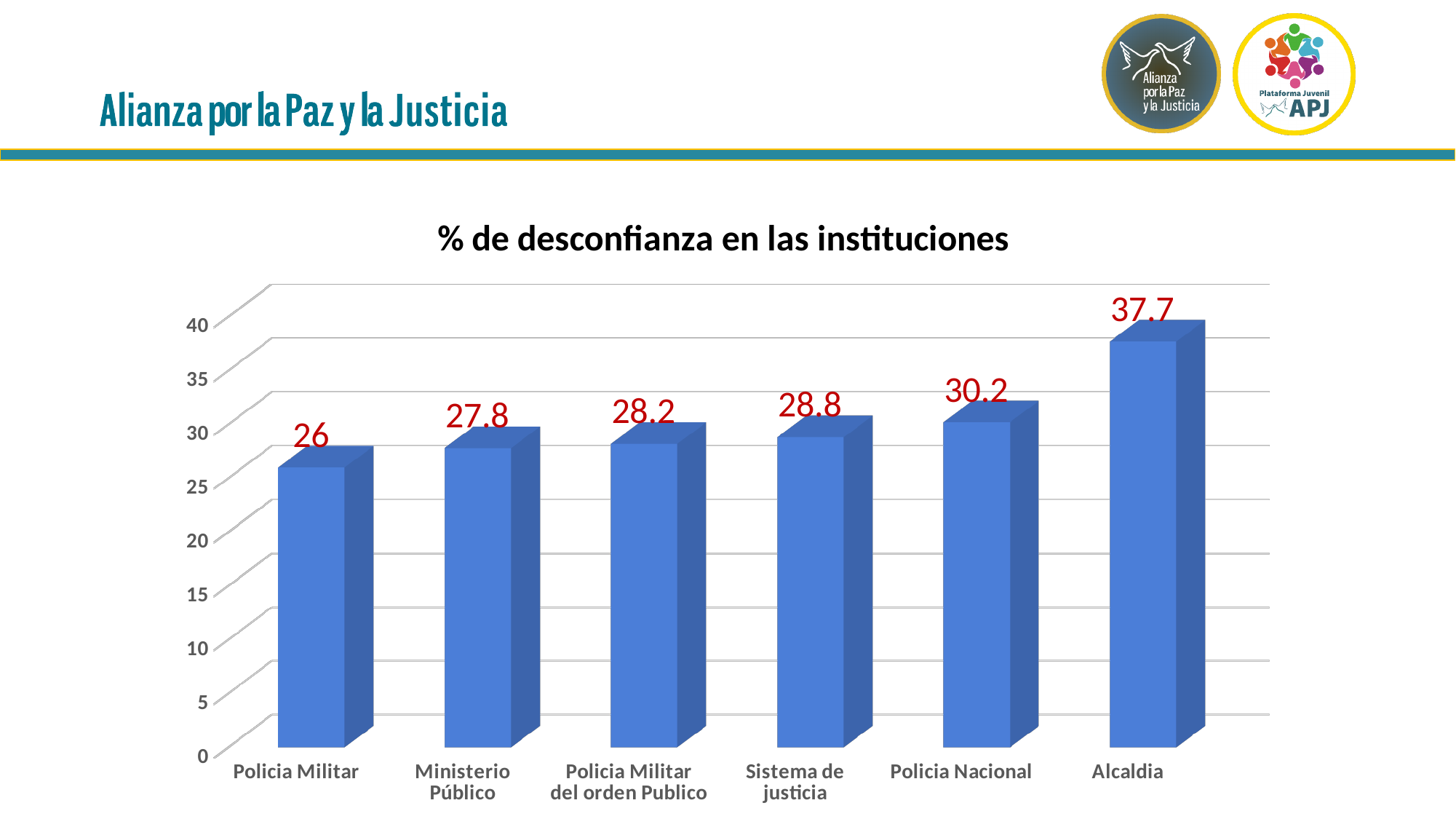
Which institution has the lowest value? Policia Militar What is the title of the chart? % de desconfianza en las instituciones What is the value for Alcaldia? 37.7 What is the value for Sistema de justicia? 28.8 Which is larger, the value for Policia Nacional or the value for Sistema de justicia? Policia Nacional What is the difference between the values for Policia Nacional and Ministerio Público? 2.4 How many institutions are shown on the chart? 6 Which institution has the highest value? Alcaldia What kind of chart is shown on the slide? Bar chart What is the value for Policia Militar? 26 What is the difference between the values for Alcaldia and Policia Militar? 11.7 What is the value for Policia Nacional? 30.2